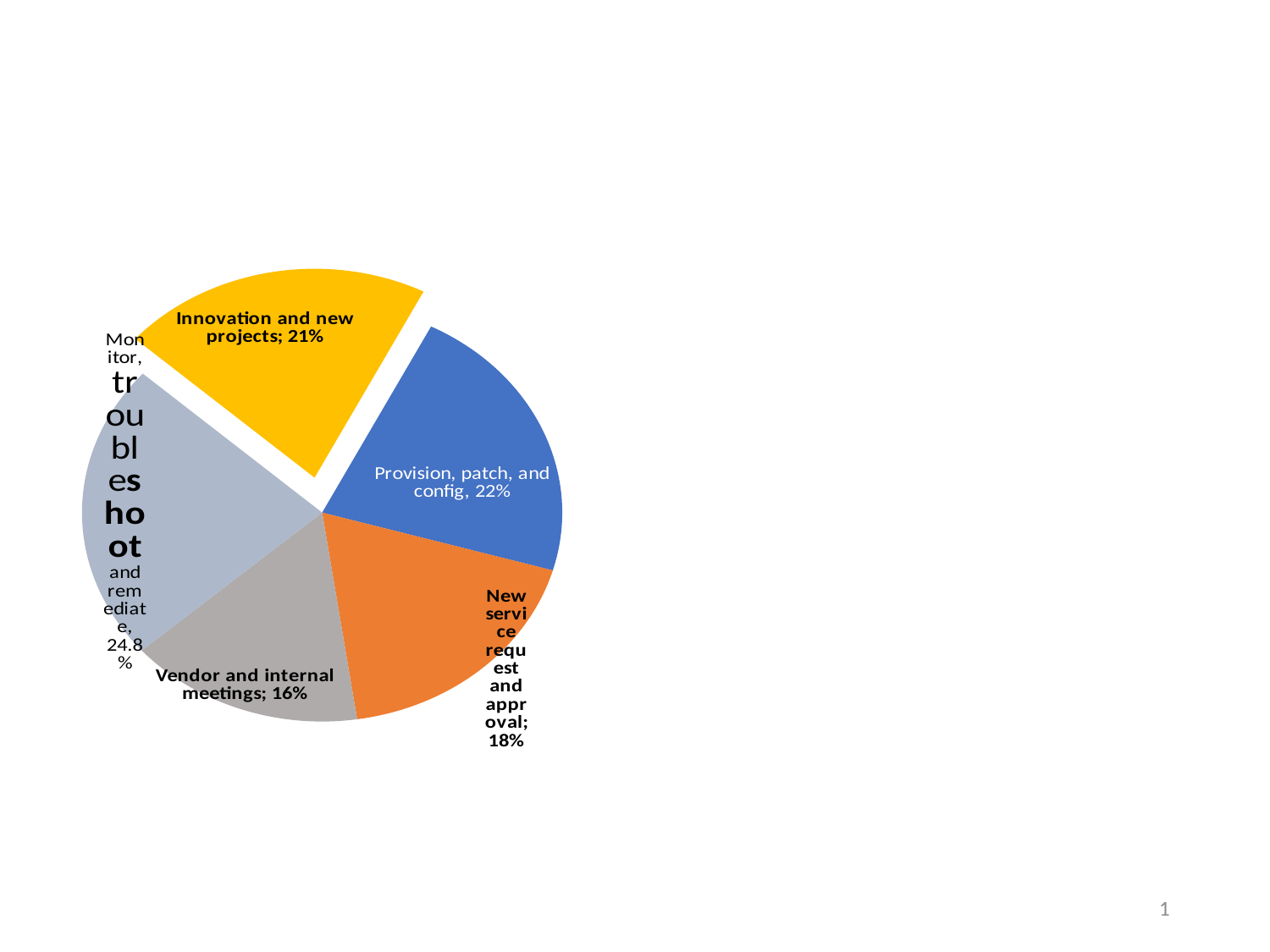
What percentage is shown for Monitor, troubleshoot and remediate? 24.8% Which is larger: the share for Provision, patch, and config or the share for Innovation and new projects? Provision, patch, and config What kind of chart is shown on the slide? Pie chart What is the difference in percentage points between Monitor, troubleshoot and remediate and Vendor and internal meetings? 8.8 What percentage is shown for Innovation and new projects? 21% How many slices does the pie chart have? 5 What percentage is shown for New service request and approval? 18% Which category has the largest share of the pie? Monitor, troubleshoot and remediate Which slice is pulled out (exploded) from the rest of the pie? Innovation and new projects What percentage is shown for Vendor and internal meetings? 16% What percentage is shown for Provision, patch, and config? 22% Which category has the smallest share of the pie? Vendor and internal meetings